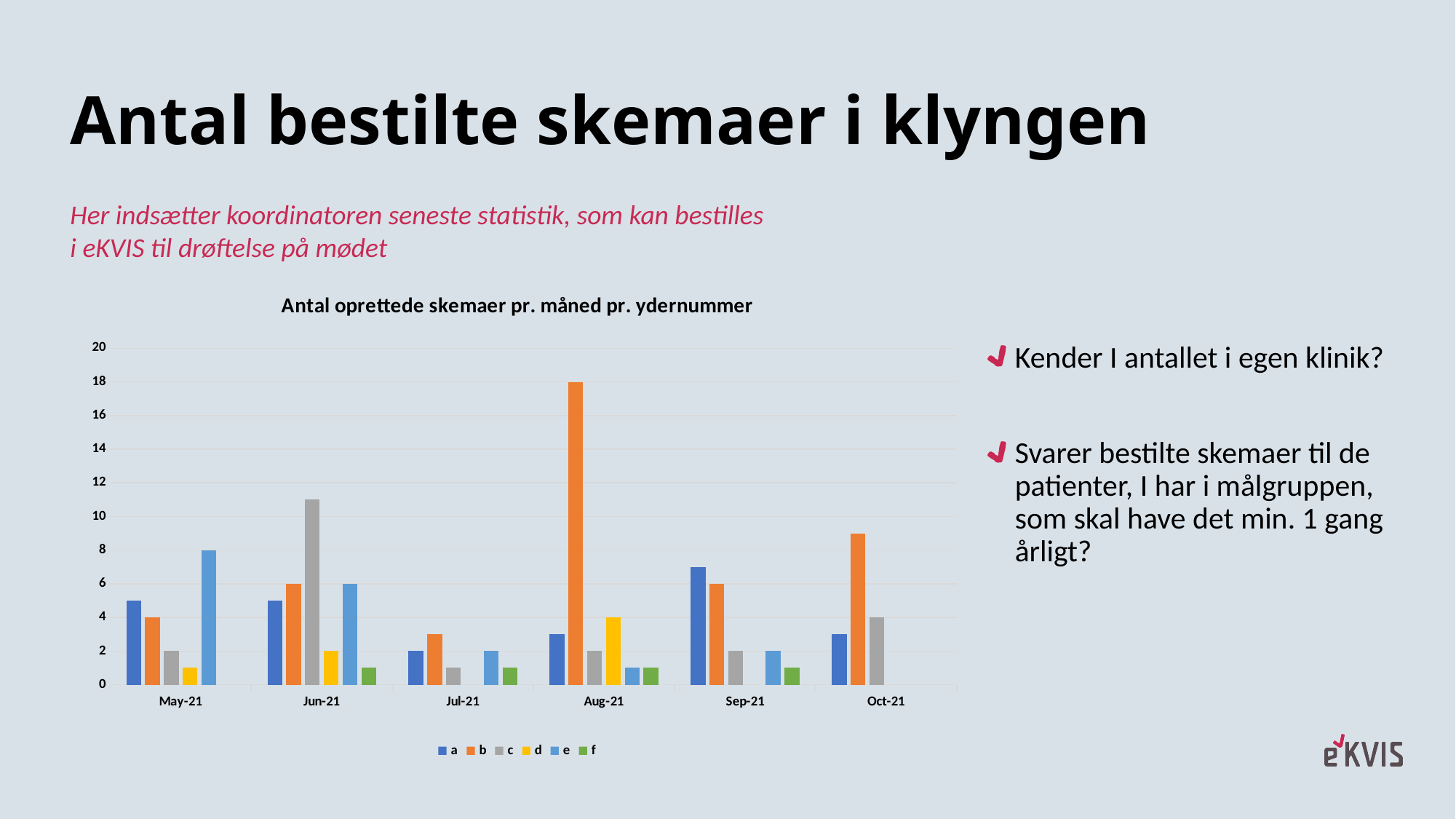
Is the value for series c in Jun-21 greater or less than 10? greater What is the value for series e in May-21? 8 Which month has the highest single bar in the chart? Aug-21 What is the value for series b in Aug-21? 18 What is the value for series b in Jun-21? 6 What is the difference between series b in Aug-21 and series e in May-21? 10 How many series does the legend list? 6 What is the title of the chart? Antal oprettede skemaer pr. måned pr. ydernummer Which is larger: series b in Aug-21 or series c in Jun-21? series b in Aug-21 Is the value for series b in Oct-21 greater or less than 8? greater How many months are shown on the x axis? 6 What kind of chart is shown on the slide? bar chart